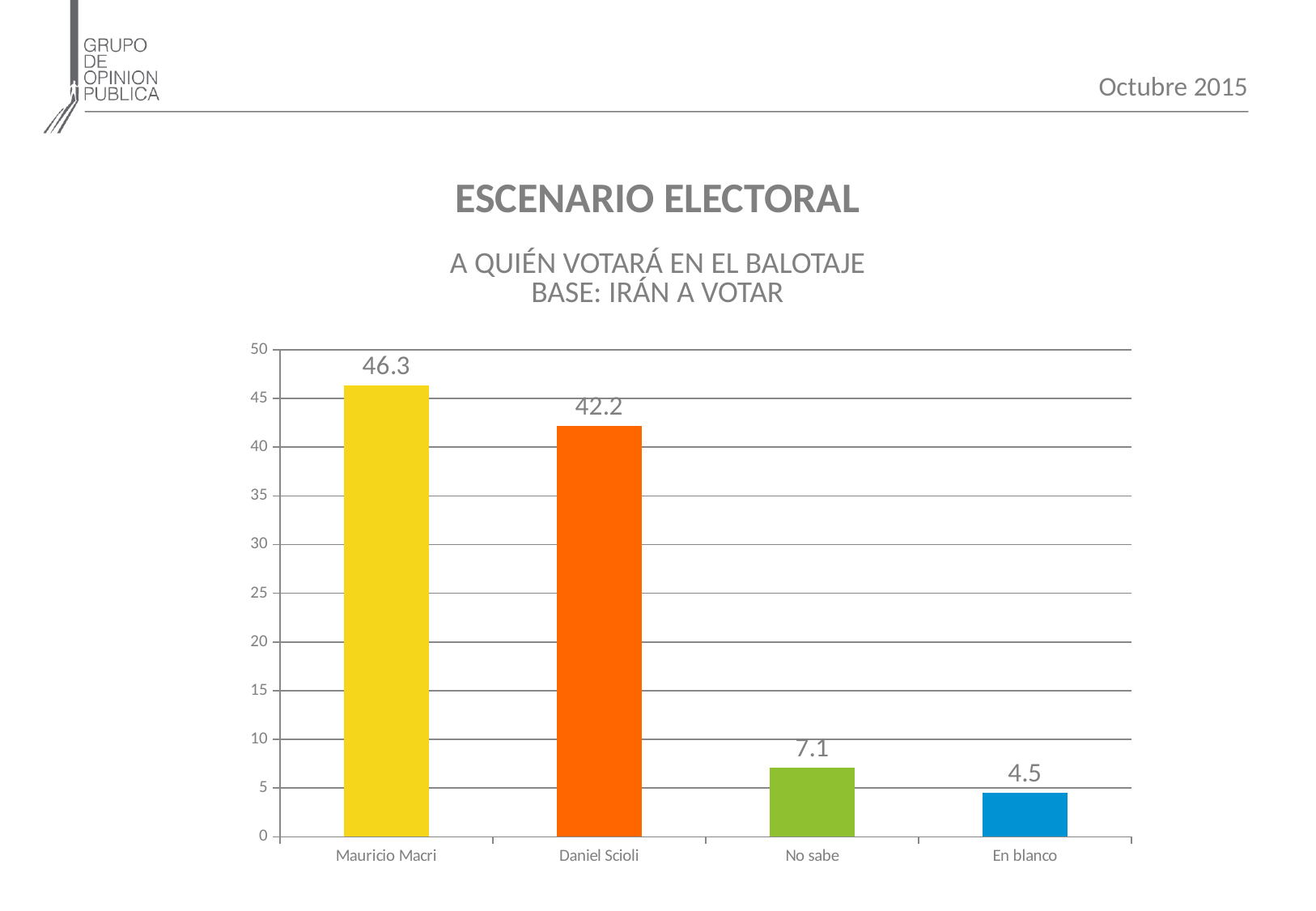
Which is larger, the value for No sabe or the value for En blanco? No sabe Which category has the highest value? Mauricio Macri What kind of chart is shown on the slide? bar chart What is the difference between the values for Mauricio Macri and Daniel Scioli? 4.1 What is the value for No sabe? 7.1 What is the value for Daniel Scioli? 42.2 Which category has the lowest value? En blanco What is the value for En blanco? 4.5 Is the value for Daniel Scioli greater or less than 40? greater What is the value for Mauricio Macri? 46.3 What is the main title of the slide above the chart? ESCENARIO ELECTORAL How many categories are shown on the x axis? 4